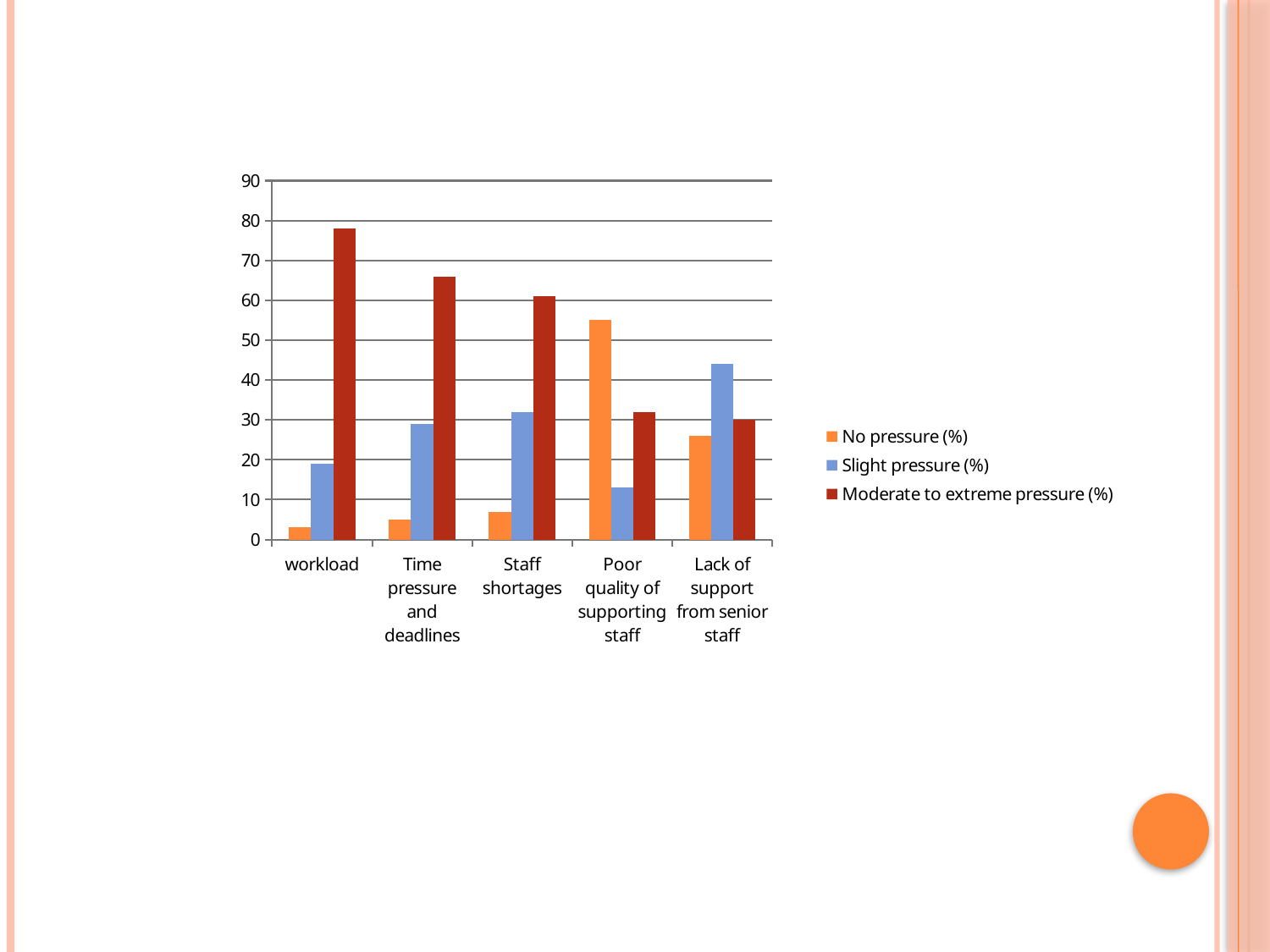
Which category has the lowest value for No pressure (%)? workload Which category has the highest value for No pressure (%)? Poor quality of supporting staff Which category has the highest value for Moderate to extreme pressure (%)? workload How many categories are shown along the x axis? 5 Is the Moderate to extreme pressure (%) value for workload greater or less than 70? greater Is the No pressure (%) value for Time pressure and deadlines greater or less than 10? less Is the Slight pressure (%) value for Lack of support from senior staff greater or less than 40? greater For Lack of support from senior staff, which is larger: Slight pressure (%) or Moderate to extreme pressure (%)? Slight pressure (%) How many series does the legend list? 3 Does the Moderate to extreme pressure (%) value rise or fall from workload to Staff shortages? fall For Poor quality of supporting staff, which is larger: No pressure (%) or Moderate to extreme pressure (%)? No pressure (%) What kind of chart is shown on the slide? Bar chart